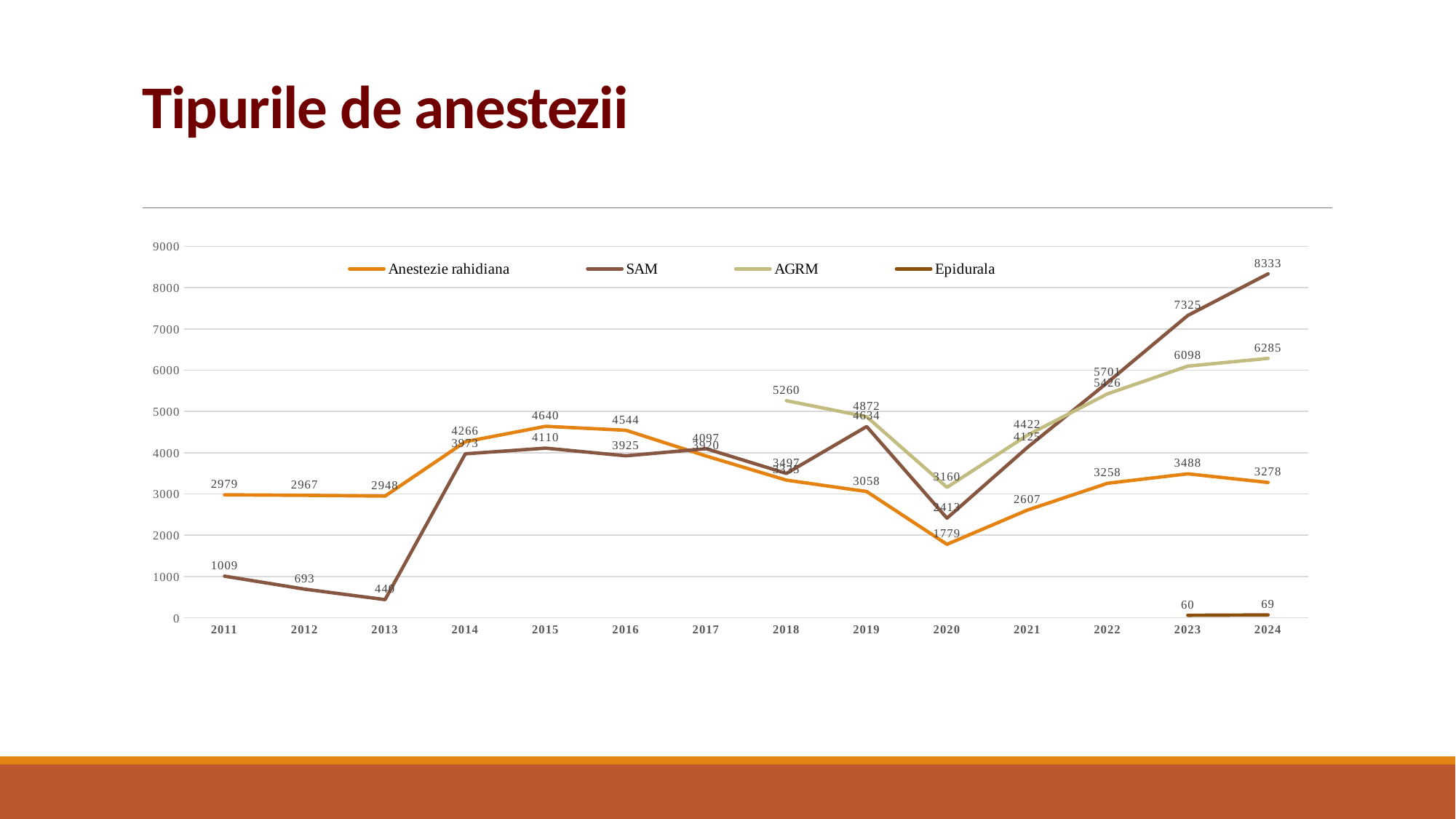
What is the value for Anestezie rahidiana in 2020? 1779 What is the value for Epidurala in 2023? 60 How many series does the legend list? 4 How many years are shown on the x axis? 14 In which year does Anestezie rahidiana reach its lowest value? 2020 What is the value for SAM in 2024? 8333 Does the SAM line rise or fall from 2020 to 2024? rise What kind of chart is shown on the slide? line chart In which year does SAM reach its highest value? 2024 Which series has the larger value in 2024, SAM or AGRM? SAM What is the value for AGRM in 2018? 5260 What is the difference between the SAM values for 2024 and 2023? 1008